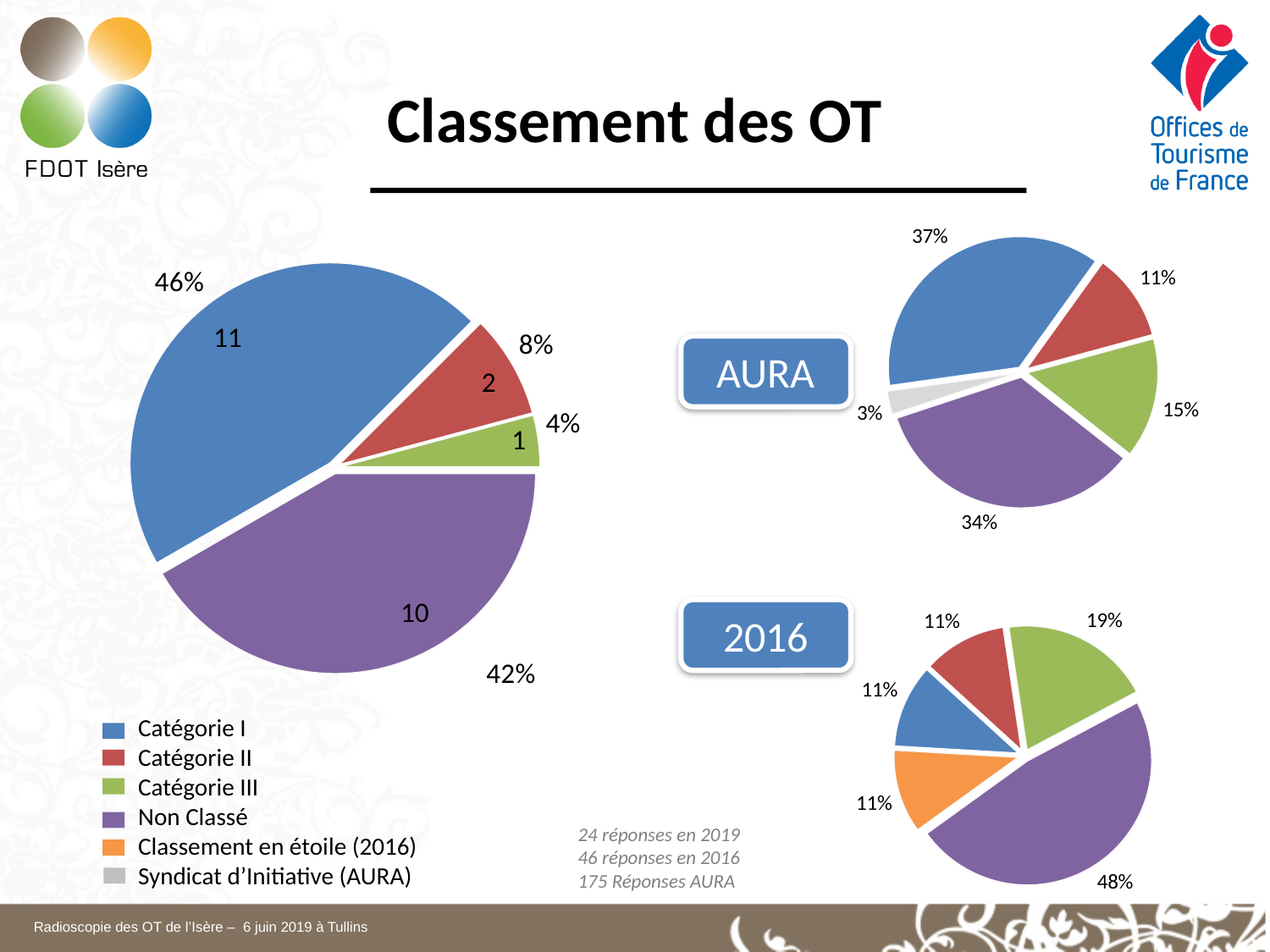
In the AURA pie chart, which category has the largest slice? Catégorie I In the large pie chart on the left, what is the difference in count between Catégorie I and Non Classé? 1 In the large pie chart on the left, how many OTs are in the Non Classé slice? 10 In the 2016 pie chart, what share does Non Classé have? 48% How many entries does the legend list? 6 How many slices does the 2016 pie chart have? 5 What type of charts are shown on the slide? Pie charts In the large pie chart on the left, which category has the smallest slice? Catégorie III In the 2016 pie chart, which is larger, Catégorie III or Catégorie I? Catégorie III In the large pie chart on the left, what share does Catégorie I have? 46% In the AURA pie chart, what share does Syndicat d'Initiative have? 3%